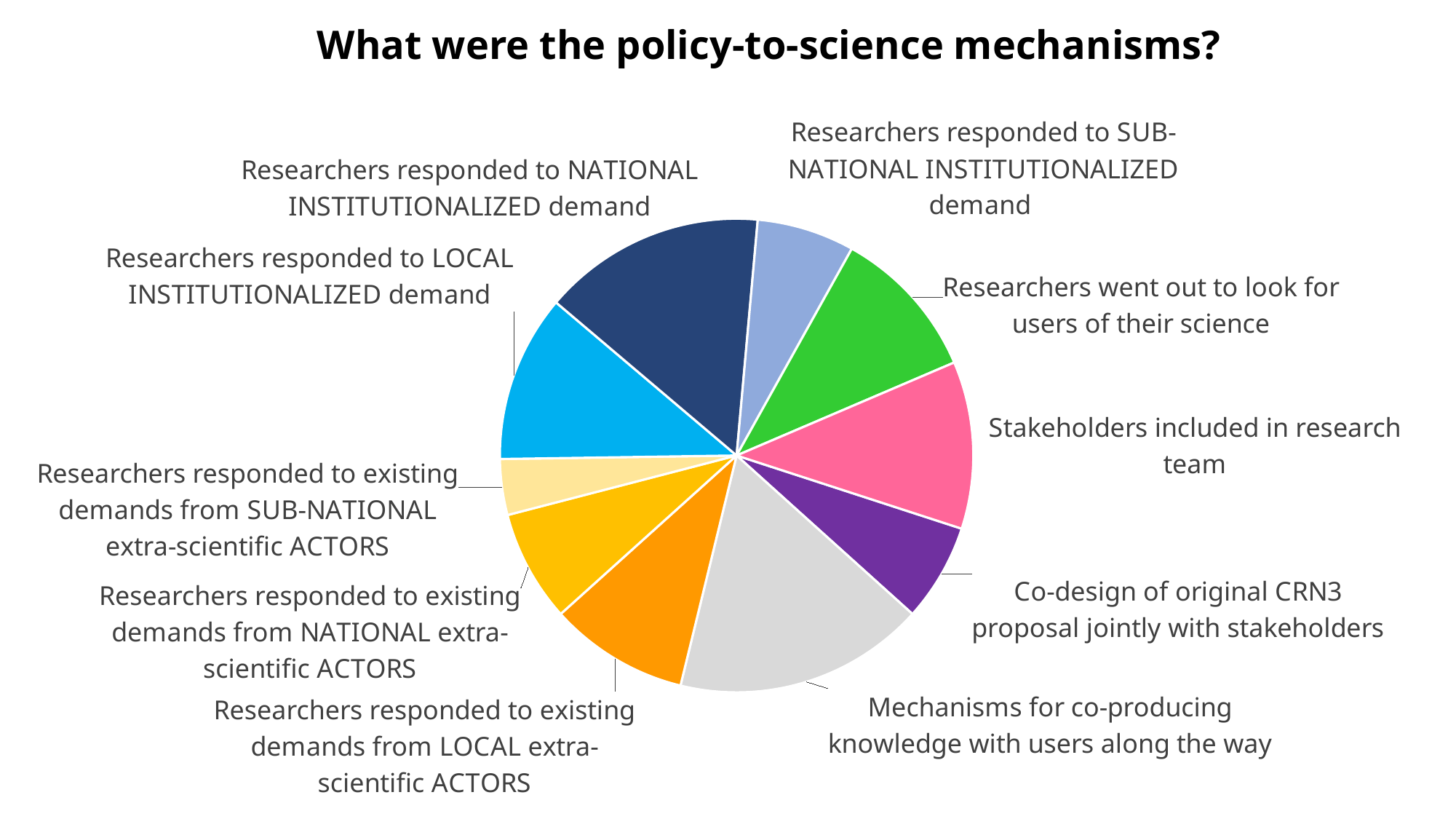
What kind of chart is shown on the slide? pie chart Which slice is larger: 'Researchers responded to LOCAL INSTITUTIONALIZED demand' or 'Researchers responded to existing demands from SUB-NATIONAL extra-scientific ACTORS'? Researchers responded to LOCAL INSTITUTIONALIZED demand What colour is the slice for 'Mechanisms for co-producing knowledge with users along the way'? grey Which slice is larger: 'Stakeholders included in research team' or 'Researchers responded to existing demands from SUB-NATIONAL extra-scientific ACTORS'? Stakeholders included in research team Which slice is larger: 'Researchers responded to NATIONAL INSTITUTIONALIZED demand' or 'Researchers responded to SUB-NATIONAL INSTITUTIONALIZED demand'? Researchers responded to NATIONAL INSTITUTIONALIZED demand Which category has the largest slice of the pie? Mechanisms for co-producing knowledge with users along the way Which category has the smallest slice of the pie? Researchers responded to existing demands from SUB-NATIONAL extra-scientific ACTORS How many slices does the pie chart have? 10 What is the title of the chart? What were the policy-to-science mechanisms?